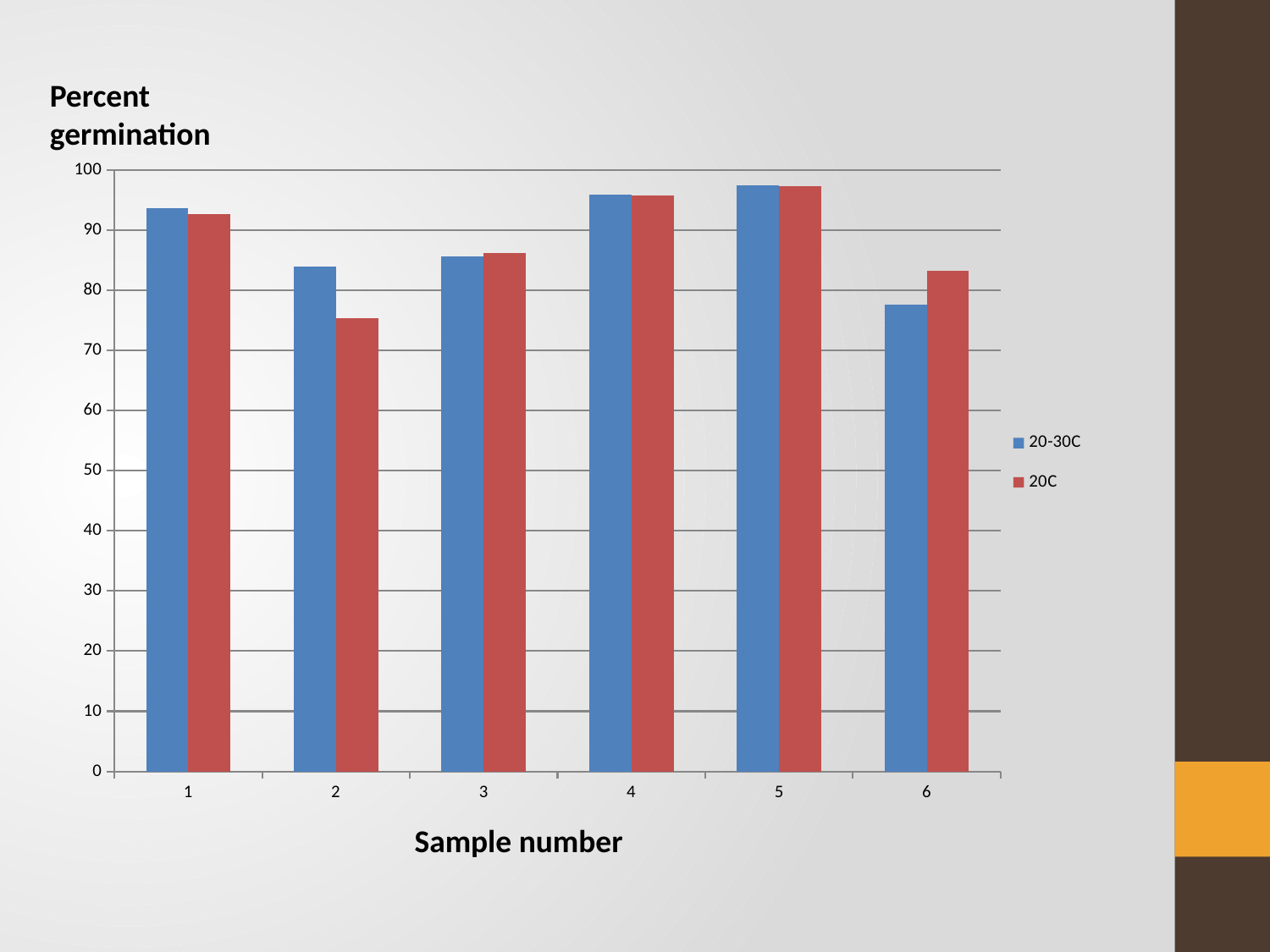
What kind of chart is shown on the slide? bar chart What is the label of the x axis? Sample number Is the value for the 20C series at sample 2 greater or less than 80? less What is the label of the y axis? Percent germination For sample 2, which series has the larger value, 20-30C or 20C? 20-30C How many series does the legend list? 2 Which sample number has the lowest value for the 20C series? 2 For sample 6, which series has the larger value, 20-30C or 20C? 20C How many sample numbers are shown on the x axis? 6 Which sample number has the highest value for the 20-30C series? 5 Is the value for the 20-30C series at sample 4 greater or less than 90? greater Which sample number has the lowest value for the 20-30C series? 6